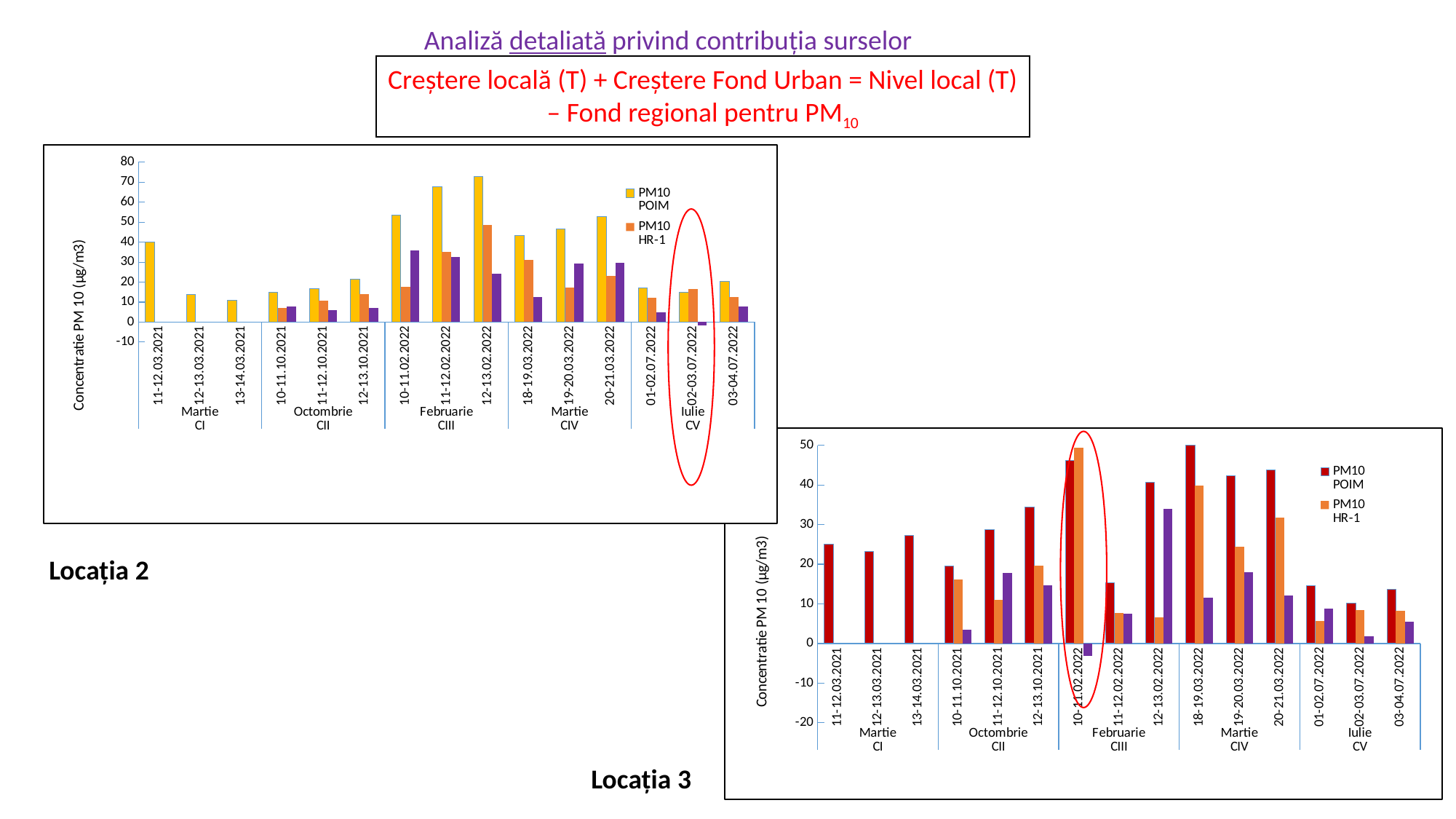
What is the y-axis label of the Locația 3 chart? Concentratie PM 10 (µg/m3) In the Locația 2 chart, which is larger, the PM10 POIM value for 11-12.03.2021 or for 13-14.03.2021? 11-12.03.2021 In the Locația 2 chart, which date has the highest PM10 POIM value? 12-13.02.2022 What kind of chart is shown for Locația 2? bar chart How many series does the legend list in the Locația 3 chart? 2 In the Locația 2 chart, is the PM10 POIM value for 10-11.02.2022 greater or less than 50? greater In the Locația 3 chart, which date has the highest PM10 HR-1 value? 10-11.02.2022 In the Locația 3 chart, is the PM10 POIM value for 11-12.03.2021 greater or less than 20? greater Which date is circled in red in the Locația 3 chart? 10-11.02.2022 In the Locația 3 chart, which is larger, the PM10 POIM value for 18-19.03.2022 or for 02-03.07.2022? 18-19.03.2022 How many date categories are shown on the x axis of the Locația 2 chart? 15 In the Locația 2 chart, is the PM10 POIM value for 12-13.02.2022 greater or less than 70? greater